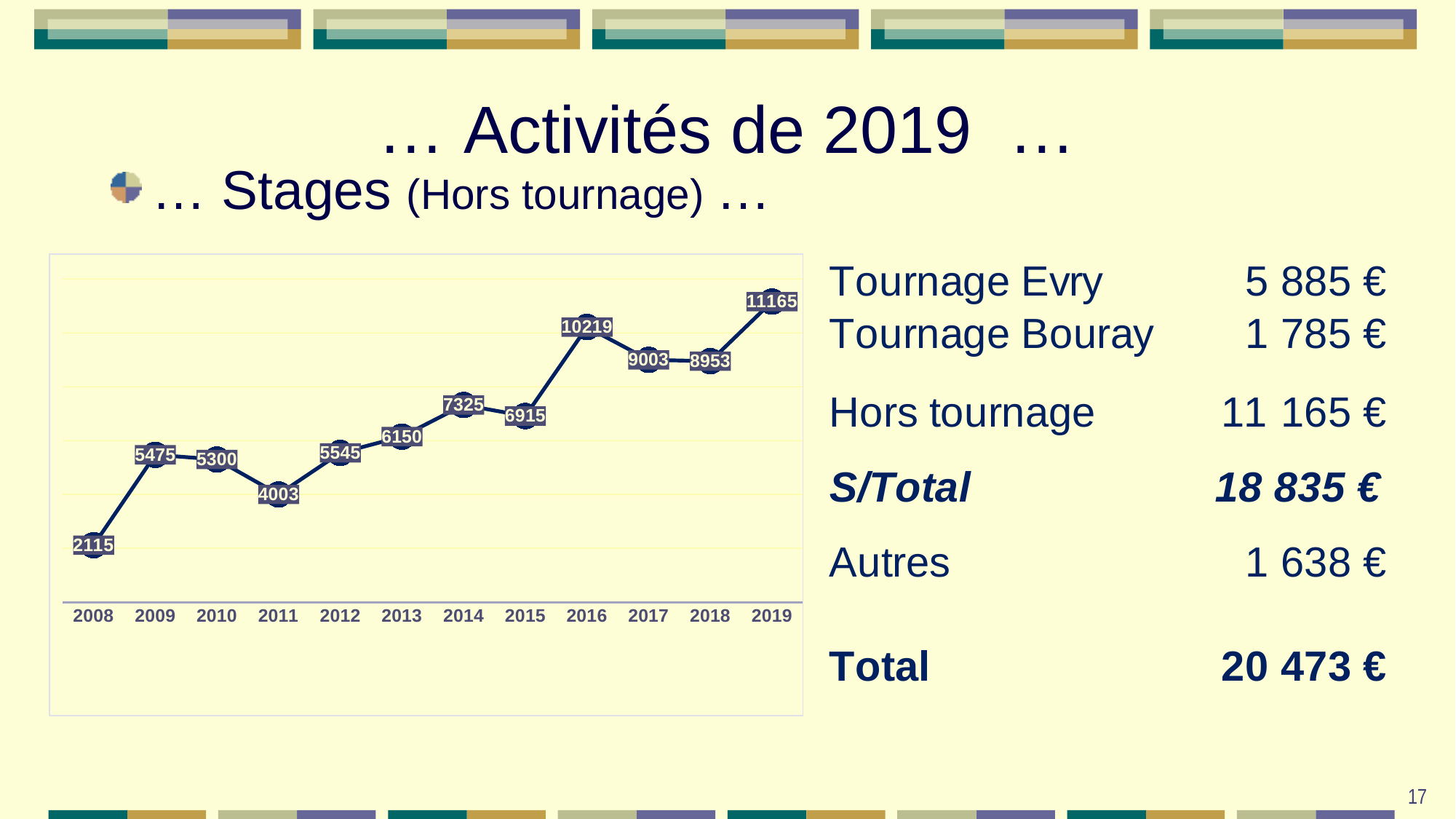
What is the difference between the values for 2016 and 2015? 3304 What is the value plotted for 2008? 2115 Which is larger, the value for 2014 or the value for 2015? 2014 What is the difference between the values for 2019 and 2018? 2212 What is the value plotted for 2019? 11165 What type of chart is shown on the slide? line chart Which year has the lowest value in the chart? 2008 How many years are plotted on the x axis of the chart? 12 What is the value plotted for 2016? 10219 What is the value plotted for 2011? 4003 Which year has the highest value in the chart? 2019 Overall, do the values rise or fall from 2008 to 2019? rise